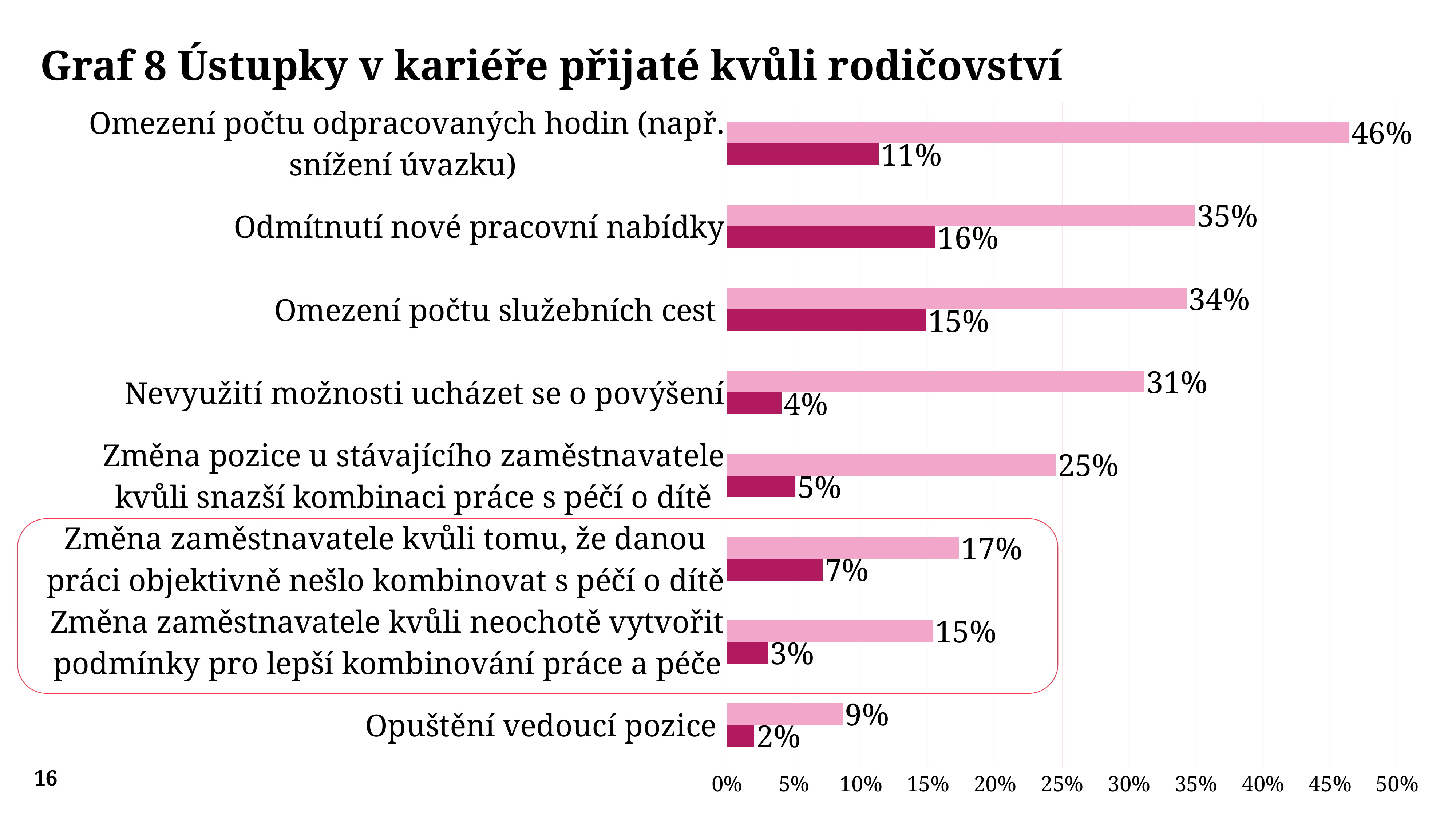
Which is larger: the dark magenta value for "Odmítnutí nové pracovní nabídky" or the dark magenta value for "Omezení počtu odpracovaných hodin (např. snížení úvazku)"? Odmítnutí nové pracovní nabídky What is the value of the dark magenta bar for "Odmítnutí nové pracovní nabídky"? 16% What is the value of the light pink bar for "Nevyužití možnosti ucházet se o povýšení"? 31% What is the title of the chart? Graf 8 Ústupky v kariéře přijaté kvůli rodičovství Which category has the lowest dark magenta bar value? Opuštění vedoucí pozice What is the difference between the light pink and dark magenta values for "Omezení počtu služebních cest"? 19% What is the highest value shown on the horizontal axis? 50% What is the value of the light pink bar for "Omezení počtu odpracovaných hodin (např. snížení úvazku)"? 46% What is the value of the dark magenta bar for "Opuštění vedoucí pozice"? 2% How many categories are shown on the chart? 8 What kind of chart is shown on the slide? Bar chart Which category has the highest light pink bar value? Omezení počtu odpracovaných hodin (např. snížení úvazku)